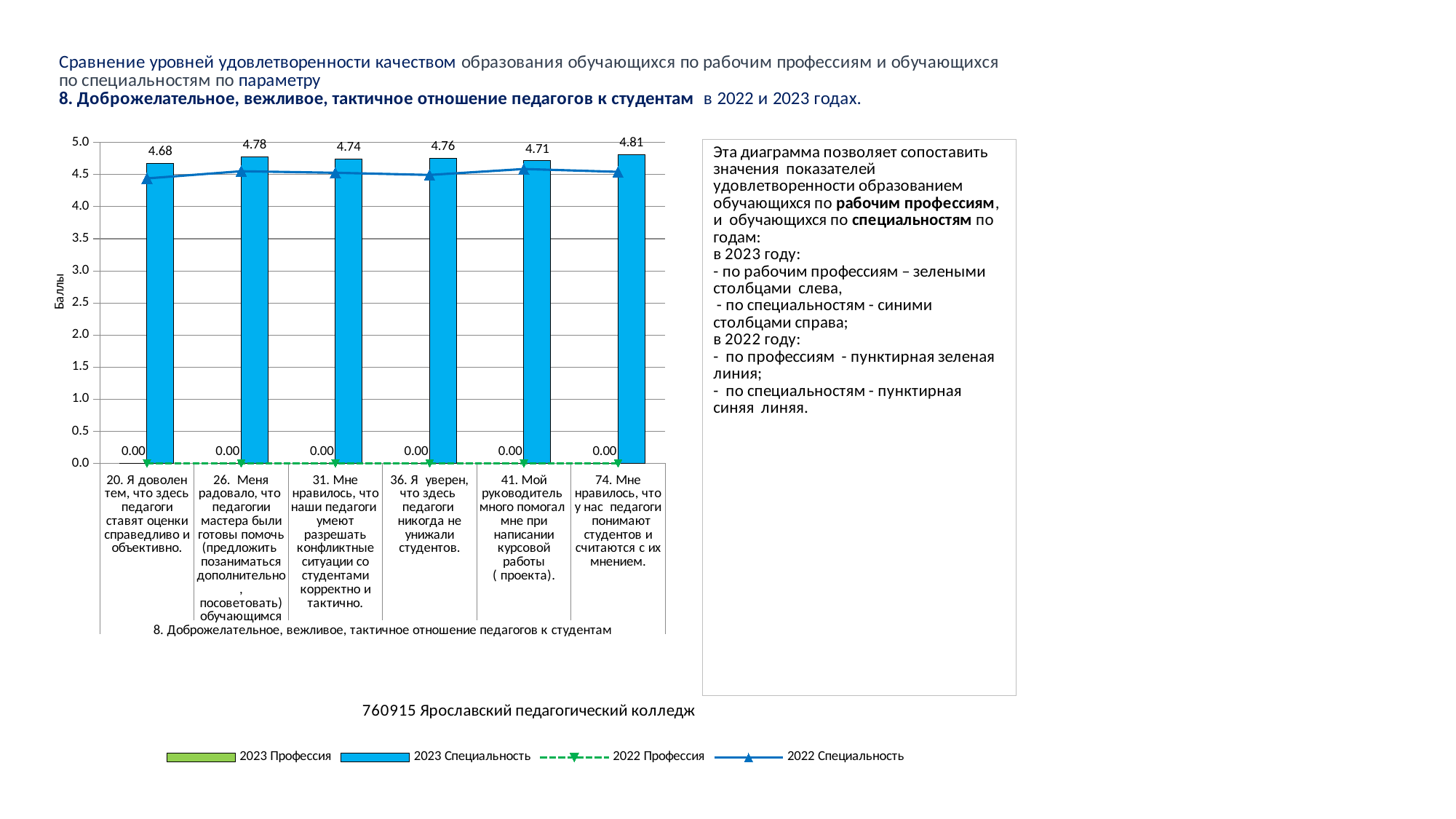
What is the value of the 2023 Специальность bar for item 74 (Мне нравилось, что у нас педагоги понимают студентов и считаются с их мнением)? 4.81 What is the value of the 2023 Специальность bar for item 20 (Я доволен тем, что здесь педагоги ставят оценки справедливо и объективно)? 4.68 What value is shown for the 2023 Профессия series for item 36? 0.00 What is the difference between the 2023 Специальность values for item 74 and item 20? 0.13 What type of chart is used for the 2023 values? Bar chart What is the label of the vertical axis of the chart? Баллы Which item has the lowest 2023 Специальность value? 20. Я доволен тем, что здесь педагоги ставят оценки справедливо и объективно. How many series does the chart legend list? 4 Which item has the highest 2023 Специальность value? 74. Мне нравилось, что у нас педагоги понимают студентов и считаются с их мнением. How many items (categories) are shown on the x axis of the chart? 6 Which is larger, the 2023 Специальность value for item 26 or for item 31? Item 26 (4.78) What is the value of the 2023 Специальность bar for item 41 (Мой руководитель много помогал мне при написании курсовой работы)? 4.71